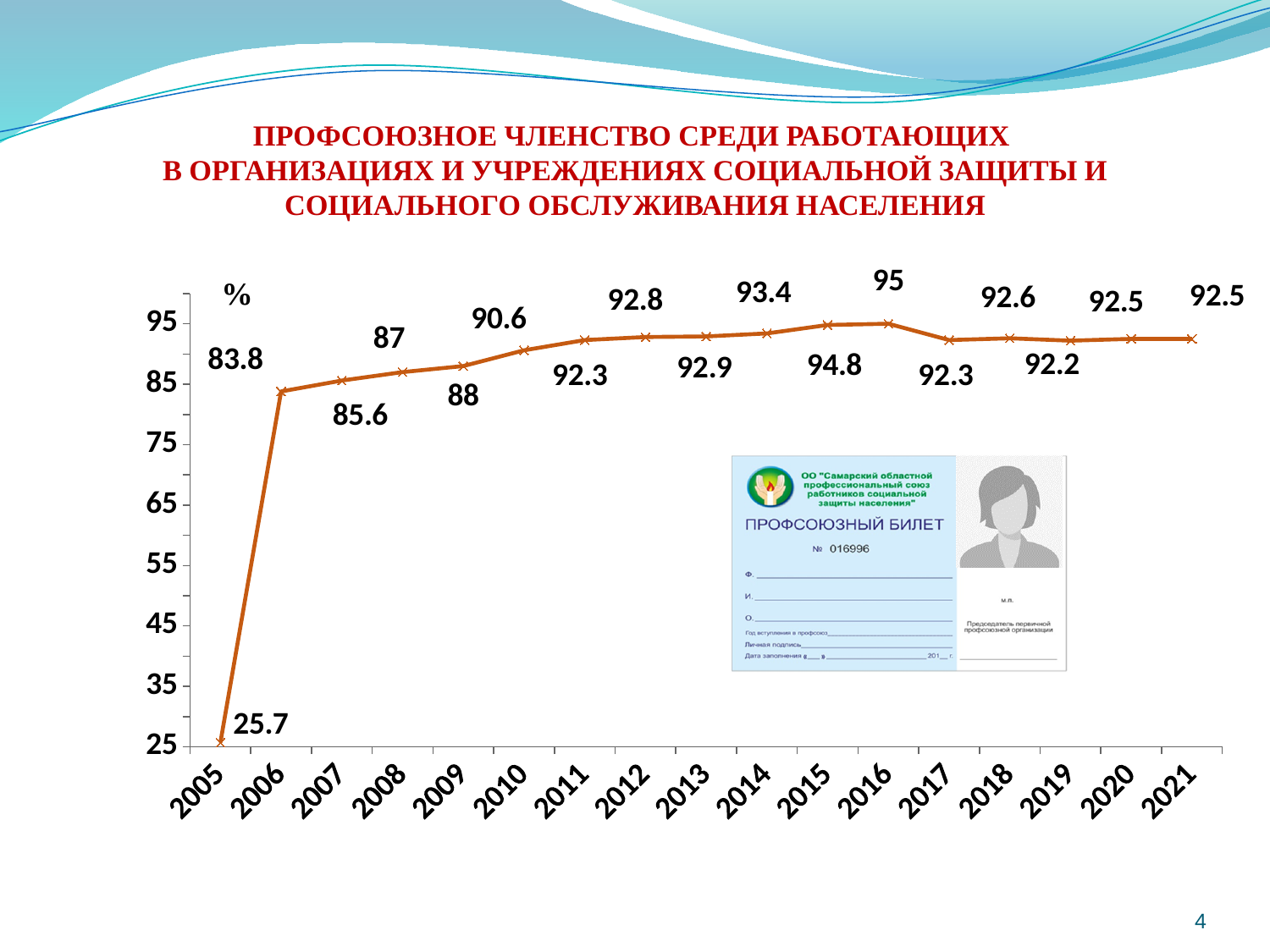
Which is larger, the value for 2015 or the value for 2018? 2015 What is the value for 2010? 90.6 Does the value rise or fall from 2005 to 2016? rise Which year has the highest value? 2016 What is the value for 2016? 95 What type of chart is shown on the slide? line chart What is the value for 2005? 25.7 What is the difference between the values for 2006 and 2005? 58.1 Which year has the lowest value? 2005 What is the difference between the values for 2016 and 2017? 2.7 How many years are plotted on the x axis? 17 What is the value for 2021? 92.5